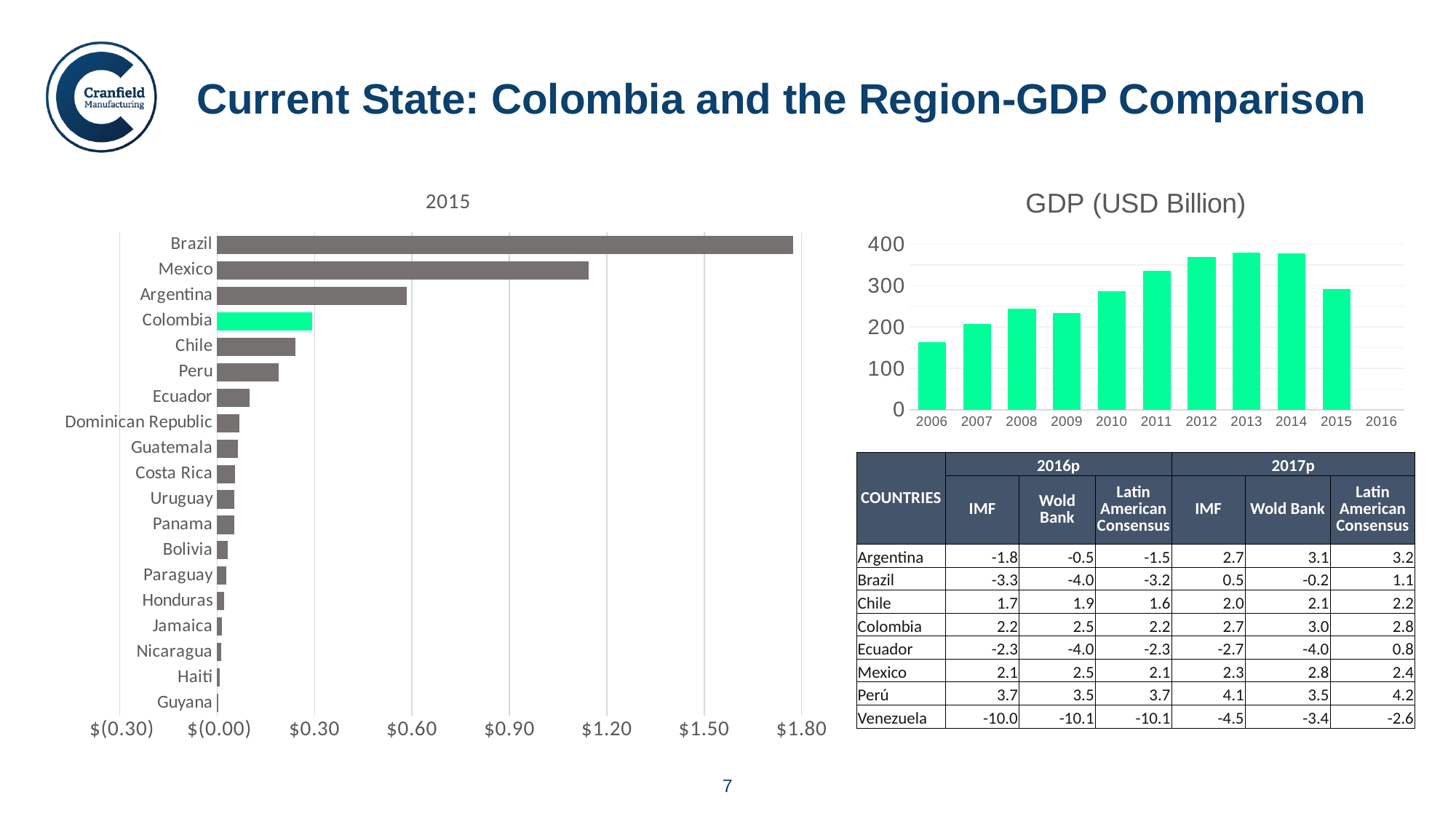
On the left chart titled "2015", which country has the lowest value? Guyana On the left chart titled "2015", is the value for Brazil greater or less than $1.50? greater On the "GDP (USD Billion)" chart, which year has the lowest value? 2006 On the left chart titled "2015", which is larger, the value for Argentina or the value for Colombia? Argentina On the "GDP (USD Billion)" chart, which is larger, the value for 2012 or the value for 2015? 2012 On the left chart titled "2015", which bar is coloured green rather than grey? Colombia On the left chart titled "2015", is the value for Mexico greater or less than $0.90? greater On the "GDP (USD Billion)" chart, is the value for 2011 greater or less than 300? greater On the left chart titled "2015", how many countries are listed? 19 On the left chart titled "2015", which country has the highest value? Brazil What kind of chart is the "GDP (USD Billion)" chart on the right? bar chart